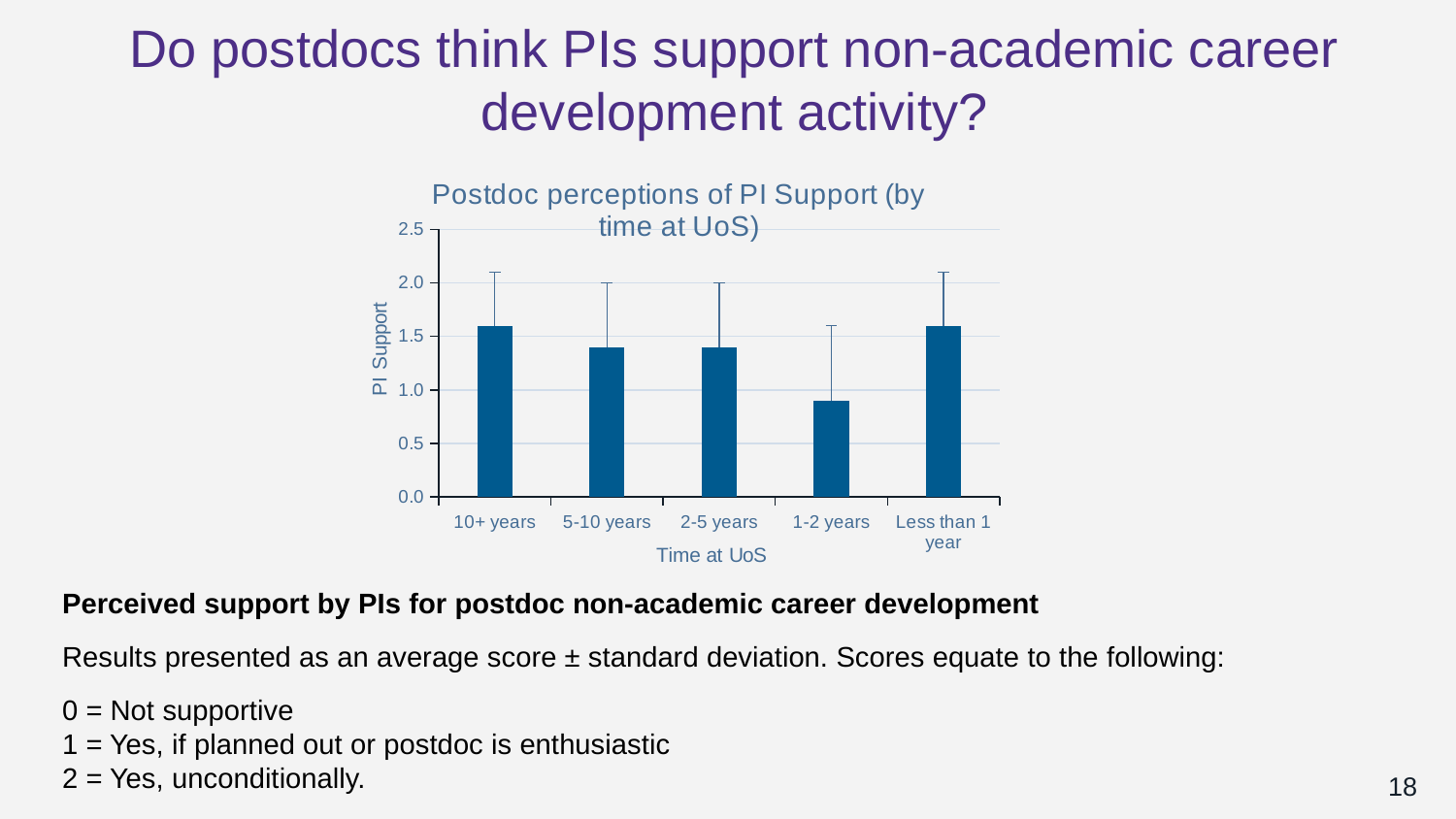
Which has a higher PI Support score, 1-2 years or Less than 1 year? Less than 1 year Which has a higher PI Support score, 10+ years or 1-2 years? 10+ years Is the PI Support value for 10+ years greater or less than 2.0? less Is the PI Support value for 1-2 years greater or less than 1.0? less Which time-at-UoS category has the lowest PI Support score? 1-2 years How many time-at-UoS categories are plotted on the x axis? 5 Is the PI Support value for Less than 1 year greater or less than 1.0? greater What is the label on the y axis of the chart? PI Support What kind of chart is shown on the slide? bar chart What is the title of the chart? Postdoc perceptions of PI Support (by time at UoS)